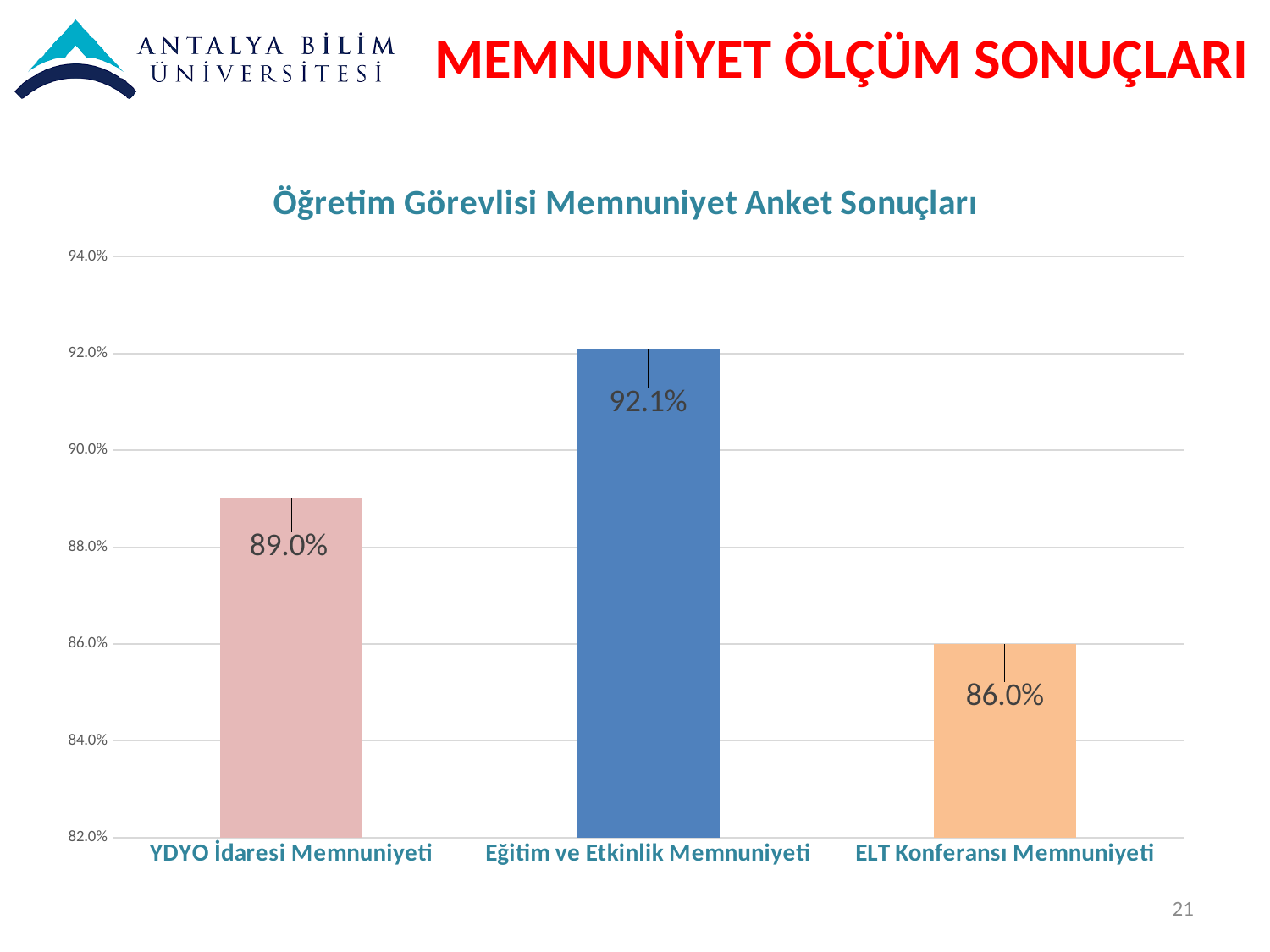
What is the value for Eğitim ve Etkinlik Memnuniyeti? 92.1% What is the difference between the values for YDYO İdaresi Memnuniyeti and ELT Konferansı Memnuniyeti? 3.0% Which category has the highest value? Eğitim ve Etkinlik Memnuniyeti Which is larger, the value for YDYO İdaresi Memnuniyeti or the value for ELT Konferansı Memnuniyeti? YDYO İdaresi Memnuniyeti How many categories are shown in the chart? 3 Which category has the lowest value? ELT Konferansı Memnuniyeti What kind of chart is shown on the slide? bar chart What is the difference between the values for Eğitim ve Etkinlik Memnuniyeti and YDYO İdaresi Memnuniyeti? 3.1% What is the value for YDYO İdaresi Memnuniyeti? 89.0% What is the title of the chart? Öğretim Görevlisi Memnuniyet Anket Sonuçları What is the value for ELT Konferansı Memnuniyeti? 86.0% Is the value for Eğitim ve Etkinlik Memnuniyeti greater or less than 90.0%? greater